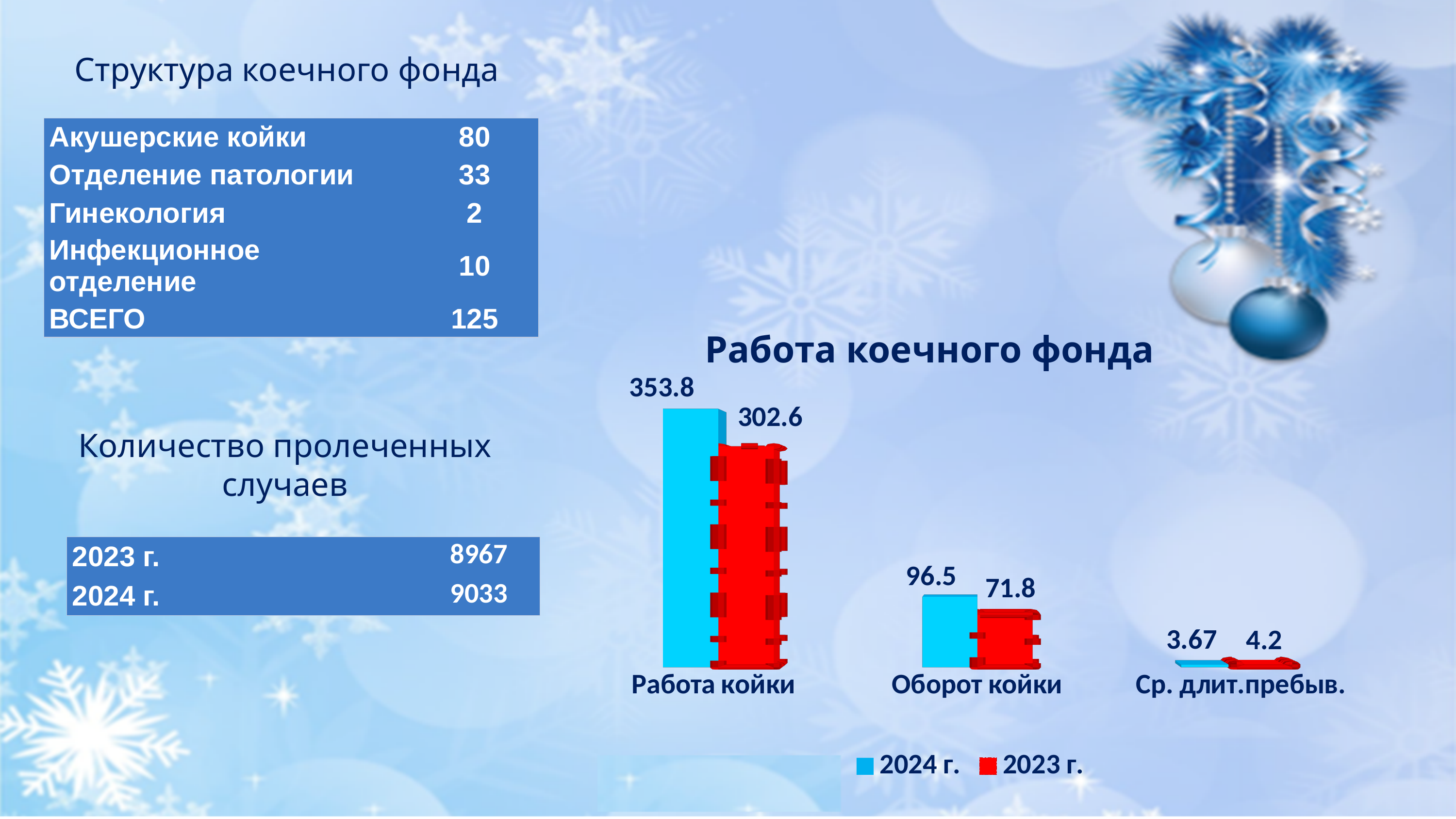
In the "Работа коечного фонда" chart, what is the value for "Работа койки" in the 2024 г. series? 353.8 How many categories are shown on the x axis of the "Работа коечного фонда" chart? 3 In the "Работа коечного фонда" chart, which category has the highest value in the 2024 г. series? Работа койки What type of chart is "Работа коечного фонда"? bar chart In the "Работа коечного фонда" chart, what is the value for "Оборот койки" in the 2024 г. series? 96.5 In the "Работа коечного фонда" chart, what is the value for "Работа койки" in the 2023 г. series? 302.6 How many series does the legend of the "Работа коечного фонда" chart list? 2 In the "Работа коечного фонда" chart, which series has the larger value for "Ср. длит.пребыв.", 2024 г. or 2023 г.? 2023 г. In the "Работа коечного фонда" chart, what is the difference between the 2024 г. and 2023 г. values for "Оборот койки"? 24.7 What is the title of the chart on the slide? Работа коечного фонда In the "Работа коечного фонда" chart, which category has the lowest value in the 2023 г. series? Ср. длит.пребыв. In the "Работа коечного фонда" chart, what is the value for "Ср. длит.пребыв." in the 2023 г. series? 4.2